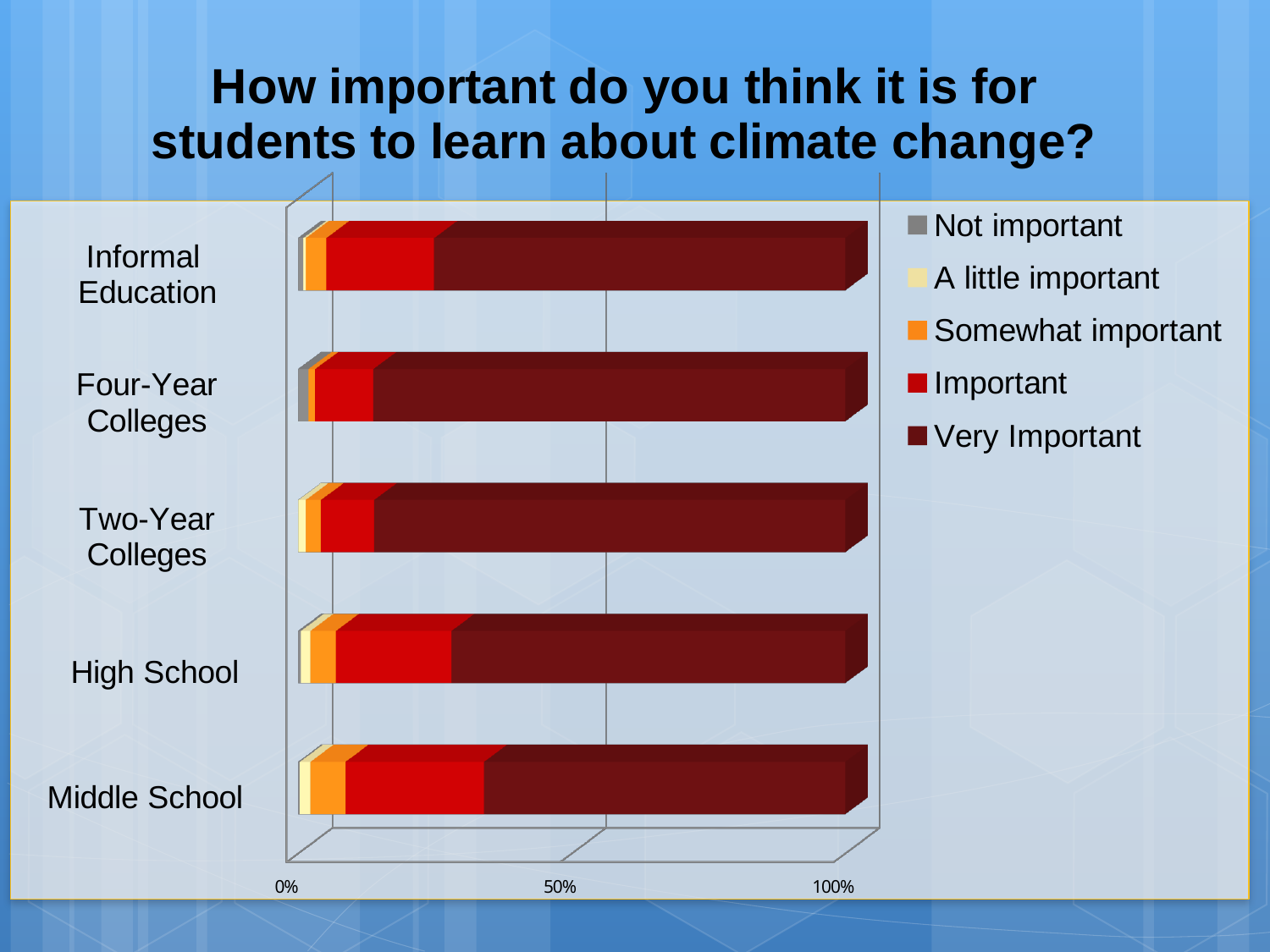
Which has the larger 'Important' share, Middle School or Four-Year Colleges? Middle School What kind of chart is shown on the slide? Stacked bar chart Is the 'Very Important' share for Middle School greater or less than 50%? greater How many categories (education levels) are shown on the chart? 5 Is the 'Very Important' share for Four-Year Colleges greater or less than 50%? greater How many series does the legend list? 5 Which category has the smallest 'Very Important' share? Middle School What is the highest value shown on the horizontal axis? 100% What is the title of the chart? How important do you think it is for students to learn about climate change? Which legend entry is shown in the darkest red colour? Very Important Is the 'Important' share for Middle School greater or less than 50%? less Which has the larger 'Very Important' share, Four-Year Colleges or Middle School? Four-Year Colleges